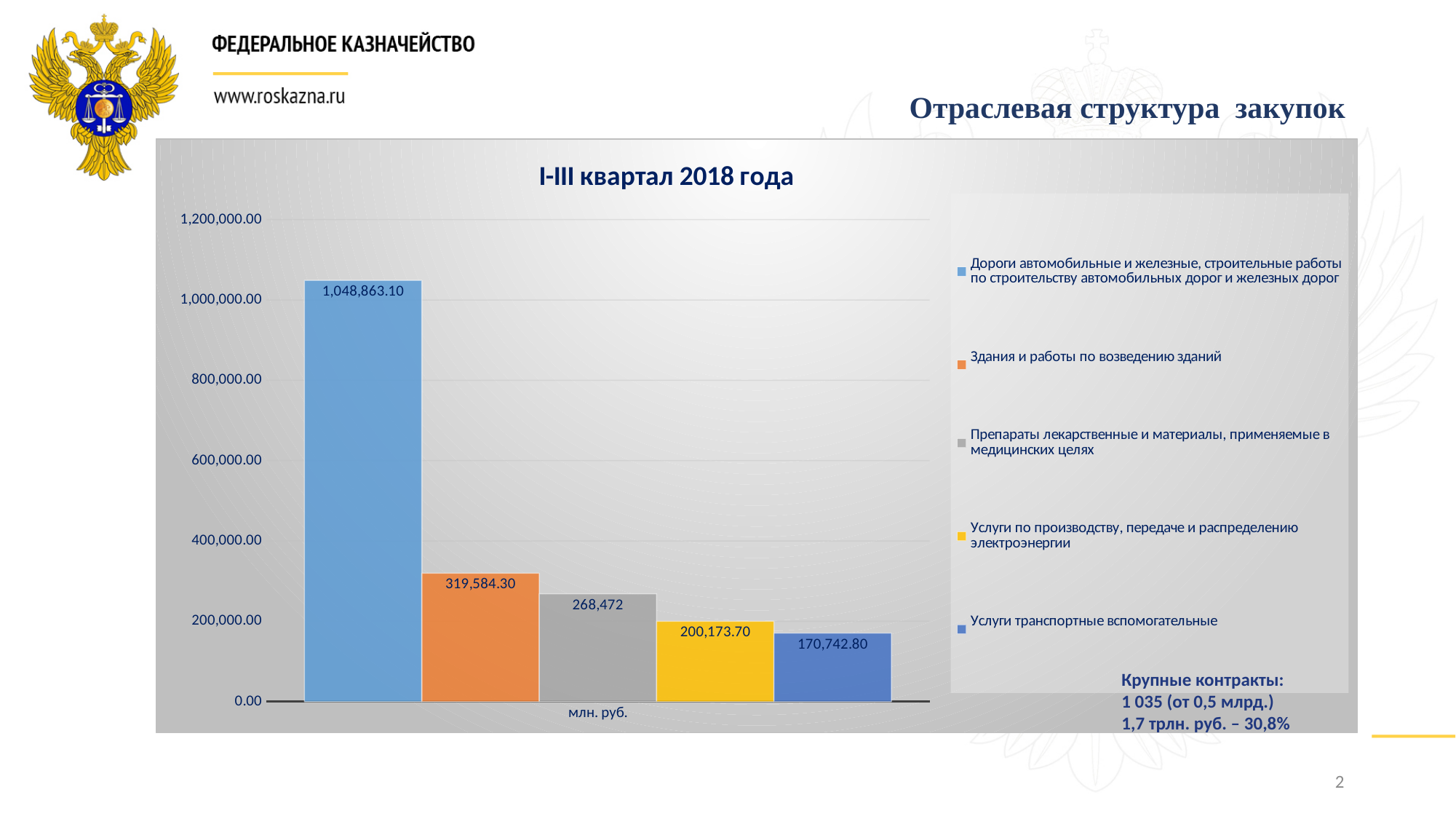
What is the value for "Препараты лекарственные и материалы, применяемые в медицинских целях"? 268,472 What is the value for "Услуги транспортные вспомогательные"? 170,742.80 Which series has the highest value? Дороги автомобильные и железные, строительные работы по строительству автомобильных дорог и железных дорог How many series does the legend list? 5 Which series has the lowest value? Услуги транспортные вспомогательные What kind of chart is shown on the slide? bar chart What is the title of the chart? I-III квартал 2018 года Which is larger: the value for "Препараты лекарственные и материалы, применяемые в медицинских целях" or the value for "Услуги по производству, передаче и распределению электроэнергии"? Препараты лекарственные и материалы, применяемые в медицинских целях Is the value for "Дороги автомобильные и железные, строительные работы по строительству автомобильных дорог и железных дорог" greater or less than 1,000,000.00? greater What is the value for "Услуги по производству, передаче и распределению электроэнергии"? 200,173.70 What is the difference between the value for "Здания и работы по возведению зданий" and the value for "Услуги транспортные вспомогательные"? 148,841.50 What is the value for "Здания и работы по возведению зданий"? 319,584.30